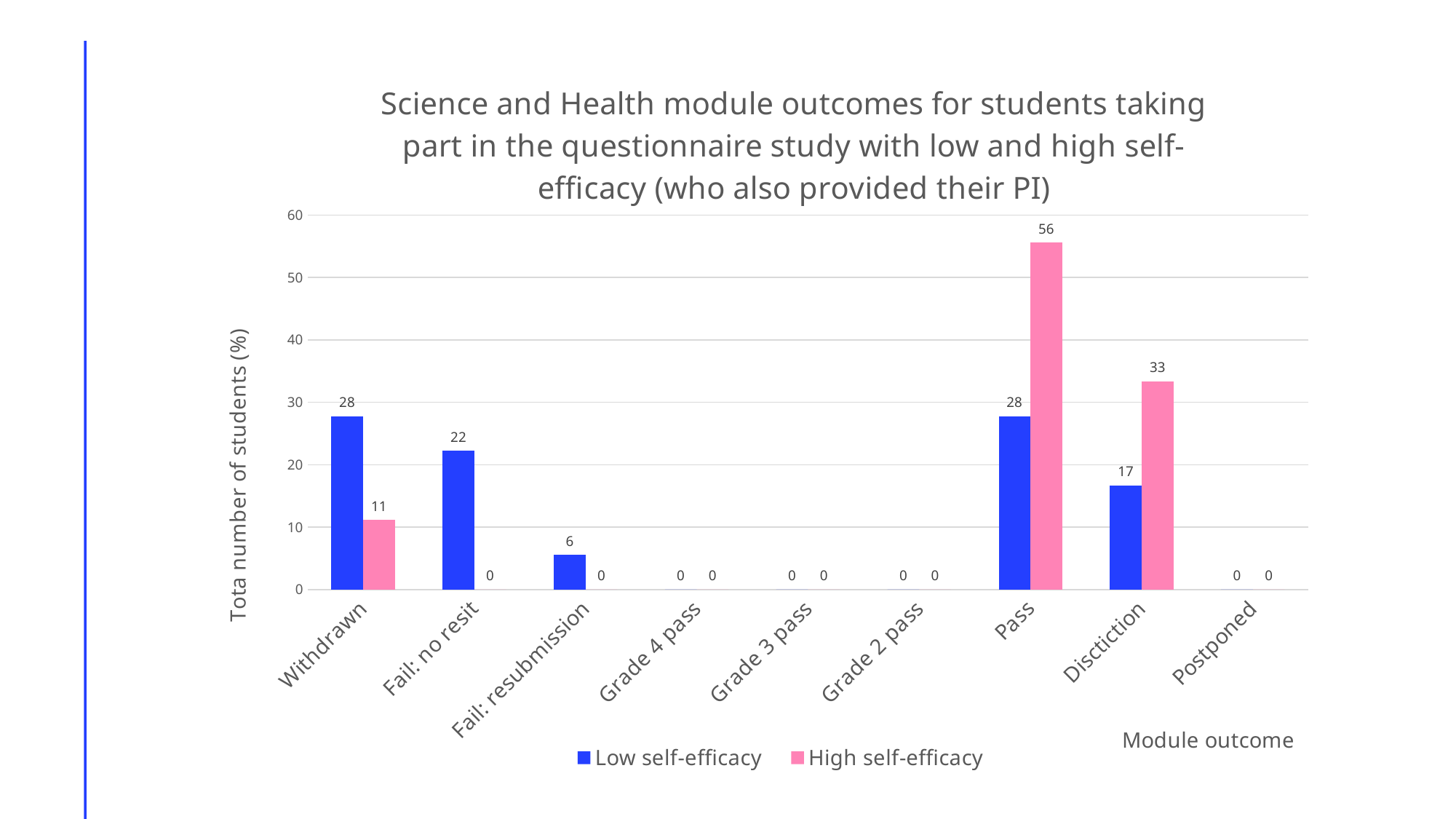
How many series does the legend list? 2 What is the value for Low self-efficacy in the Withdrawn category? 28 Which category has the highest value for the Low self-efficacy series? Withdrawn and Pass (both 28) What is the label of the y axis? Tota number of students (%) What is the difference between the High self-efficacy and Low self-efficacy values in the Pass category? 28 What is the value for Low self-efficacy in the Fail: resubmission category? 6 In the Withdrawn category, which series has the larger value, Low self-efficacy or High self-efficacy? Low self-efficacy What kind of chart is shown on the slide? Bar chart What is the value for High self-efficacy in the Pass category? 56 What is the value for High self-efficacy in the Disctiction category? 33 Which category has the highest value for the High self-efficacy series? Pass How many module outcome categories are shown on the x axis? 9